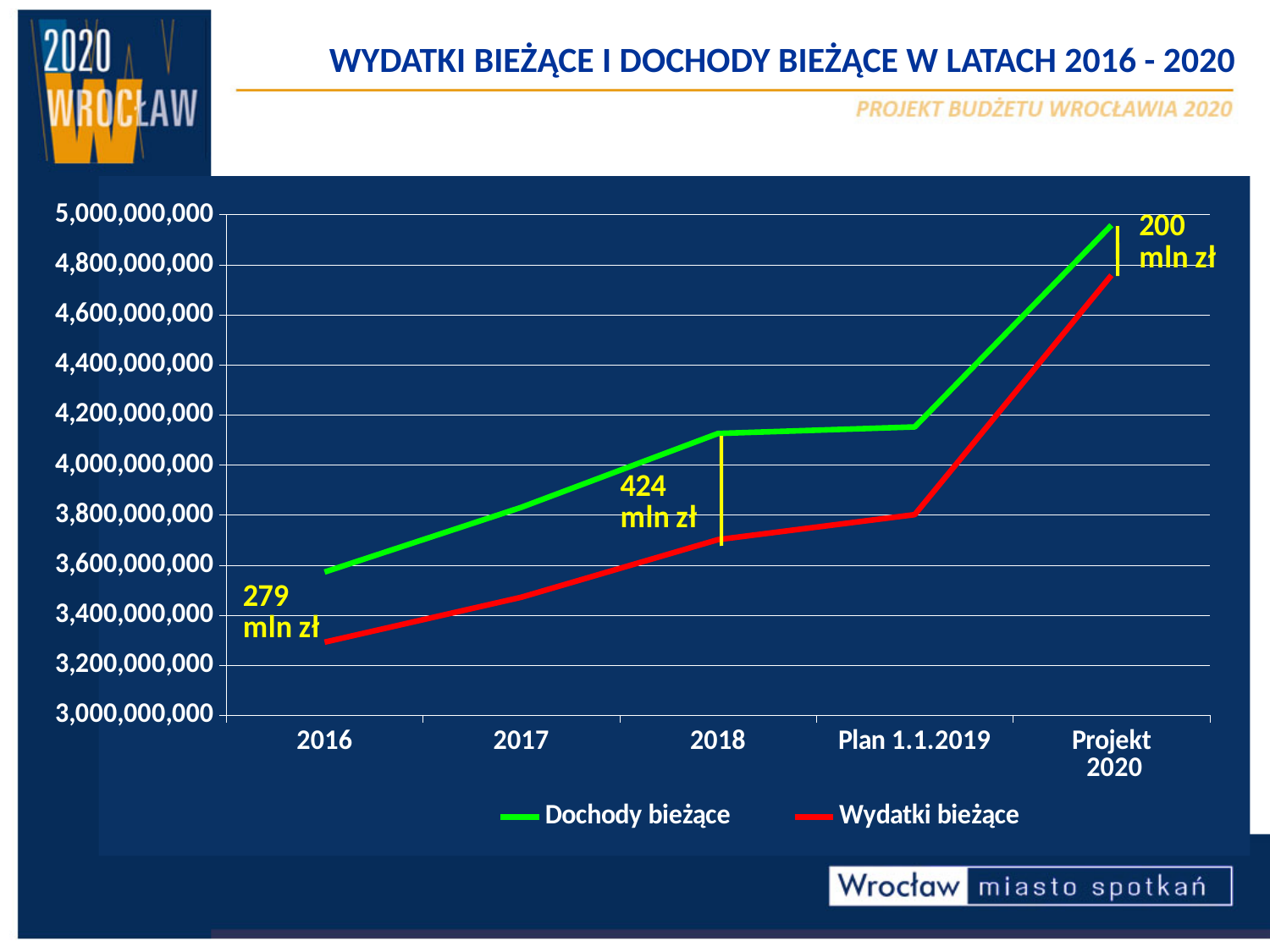
What kind of chart is shown on the slide? line chart Which colour is used for the Dochody bieżące line? green What is the title of the chart on the slide? WYDATKI BIEŻĄCE I DOCHODY BIEŻĄCE W LATACH 2016 - 2020 Do the Wydatki bieżące values rise or fall from 2016 to Projekt 2020? rise How many points along the x axis does the chart show? 5 Is the value for Wydatki bieżące in 2016 greater or less than 3,400,000,000? less Is the value for Dochody bieżące in Projekt 2020 greater or less than 4,800,000,000? greater What gap between Dochody bieżące and Wydatki bieżące is annotated for Projekt 2020? 200 mln zł In 2018, which is larger: Dochody bieżące or Wydatki bieżące? Dochody bieżące What gap between Dochody bieżące and Wydatki bieżące is annotated for 2018? 424 mln zł How many series does the legend list? 2 What gap between Dochody bieżące and Wydatki bieżące is annotated for 2016? 279 mln zł